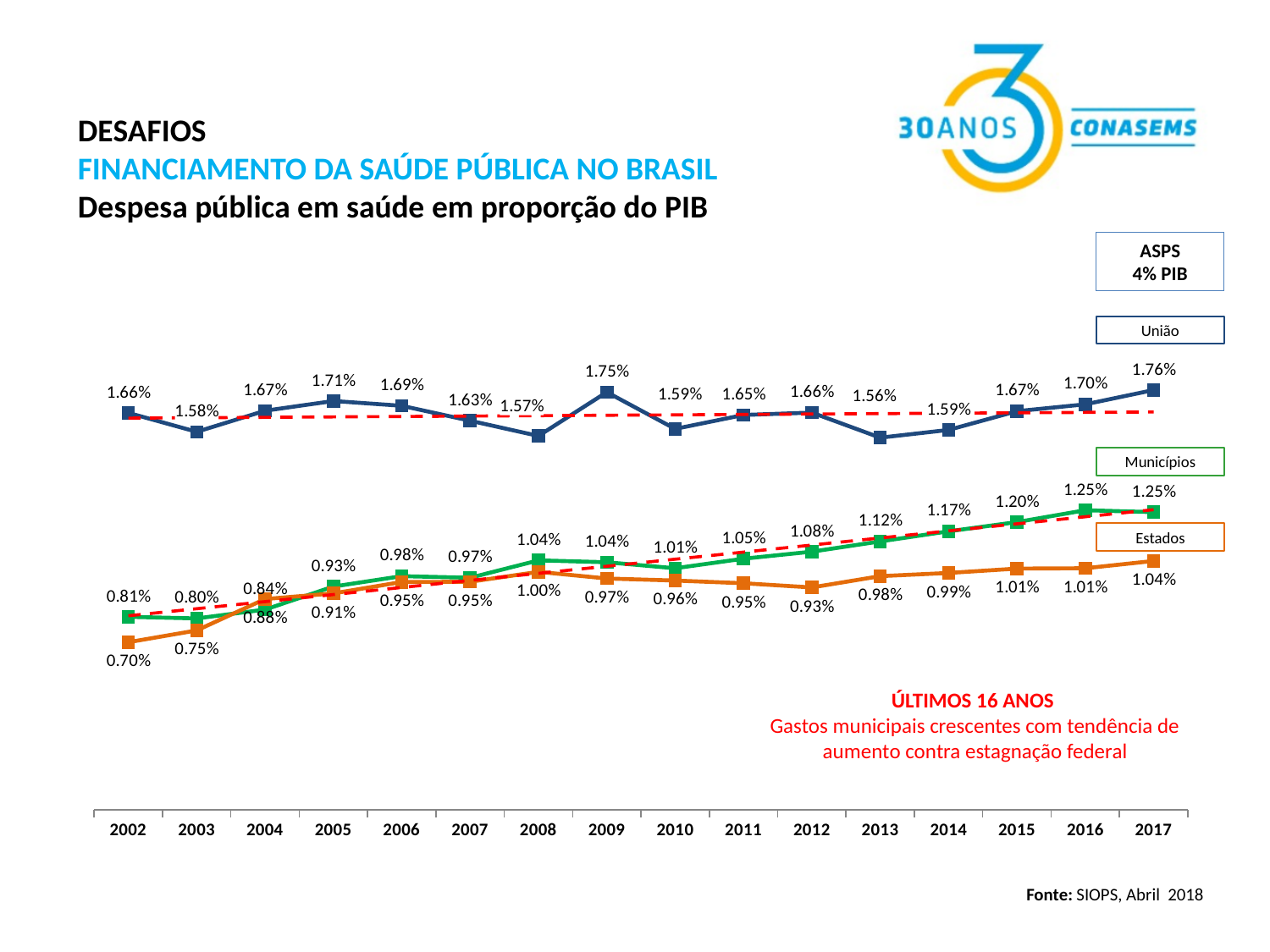
How many years are shown on the x axis? 16 Which series has the larger value in 2012, Municípios or Estados? Municípios What kind of chart is shown on the slide? Line chart What is the source cited for the chart data? SIOPS, Abril 2018 What is the difference between the União value and the Municípios value in 2017? 0.51 percentage points In which year does the União series reach its highest value? 2017 What is the value for Municípios in 2014? 1.17% In which year does the Estados series have its lowest value? 2002 What is the value for União in 2009? 1.75% What is the value for Estados in 2002? 0.70% Does the Municípios series generally rise or fall from 2002 to 2017? Rise How many series are labelled on the chart? 3